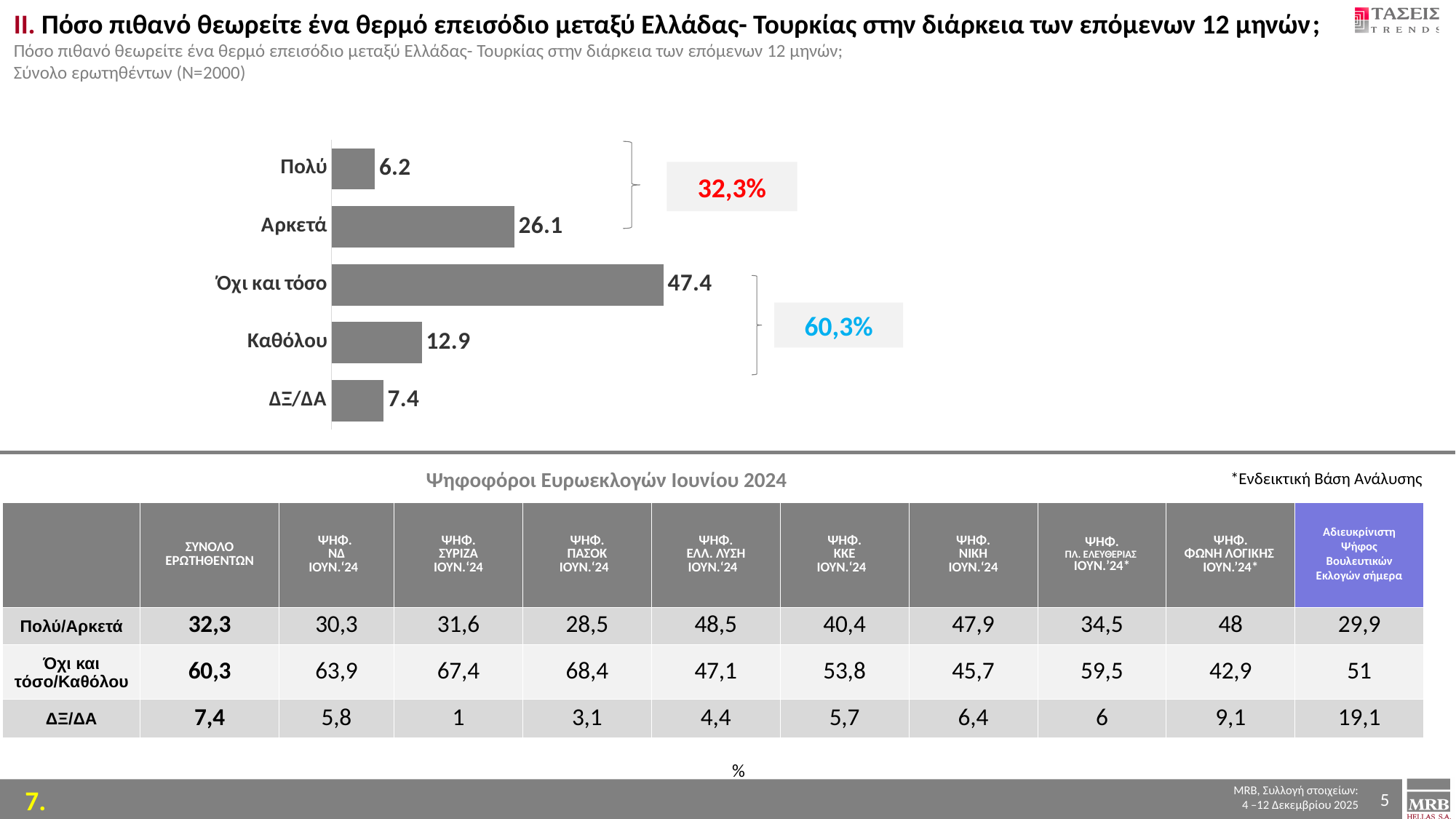
Which category has the highest value in the bar chart? Όχι και τόσο What kind of chart is shown on the slide? Bar chart What is the value for Όχι και τόσο in the bar chart? 47.4 What combined percentage is shown for the Πολύ and Αρκετά bars in the bar chart? 32,3% What is the difference between the values for Όχι και τόσο and Αρκετά in the bar chart? 21.3 Which category has the lowest value in the bar chart? Πολύ Which is larger in the bar chart, the value for Καθόλου or the value for ΔΞ/ΔΑ? Καθόλου What is the value for Πολύ in the bar chart? 6.2 What is the value for Καθόλου in the bar chart? 12.9 What is the value for ΔΞ/ΔΑ in the bar chart? 7.4 What is the value for Αρκετά in the bar chart? 26.1 How many categories are shown in the bar chart? 5